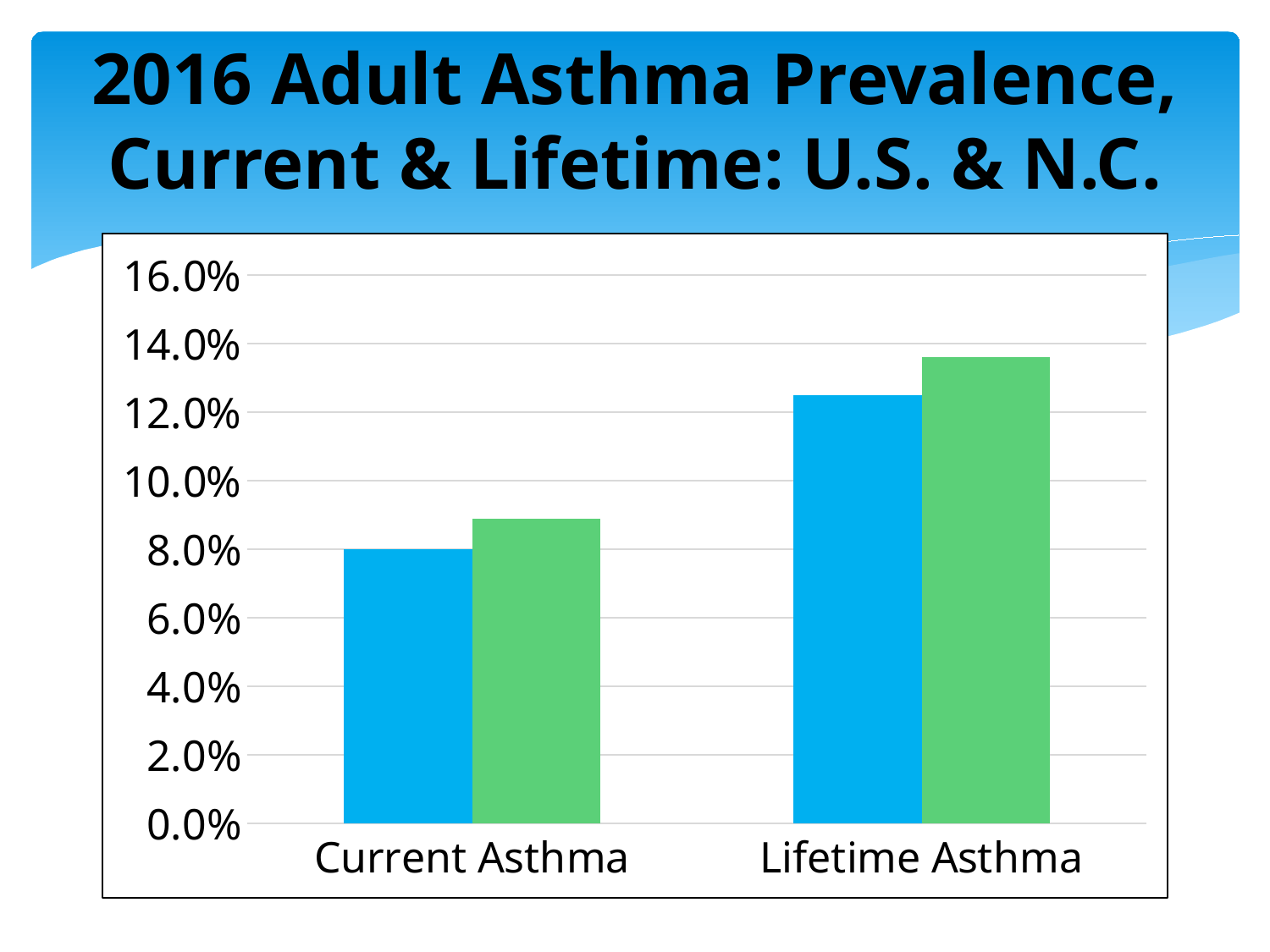
For Current Asthma, which bar is taller, the blue bar or the green bar? the green bar Which category has the tallest bar in the chart? Lifetime Asthma Is the value of the green bar for Lifetime Asthma greater or less than 12.0%? greater Is the value of the green bar for Current Asthma greater or less than 8.0%? greater Is the value of the blue bar for Lifetime Asthma greater or less than 14.0%? less Do the bar values rise or fall going from Current Asthma to Lifetime Asthma? rise Which category has the shortest bar in the chart? Current Asthma How many categories are shown on the x axis of the chart? 2 What is the title of the slide containing the chart? 2016 Adult Asthma Prevalence, Current & Lifetime: U.S. & N.C. For Lifetime Asthma, which bar is taller, the blue bar or the green bar? the green bar What kind of chart is shown on the slide? bar chart